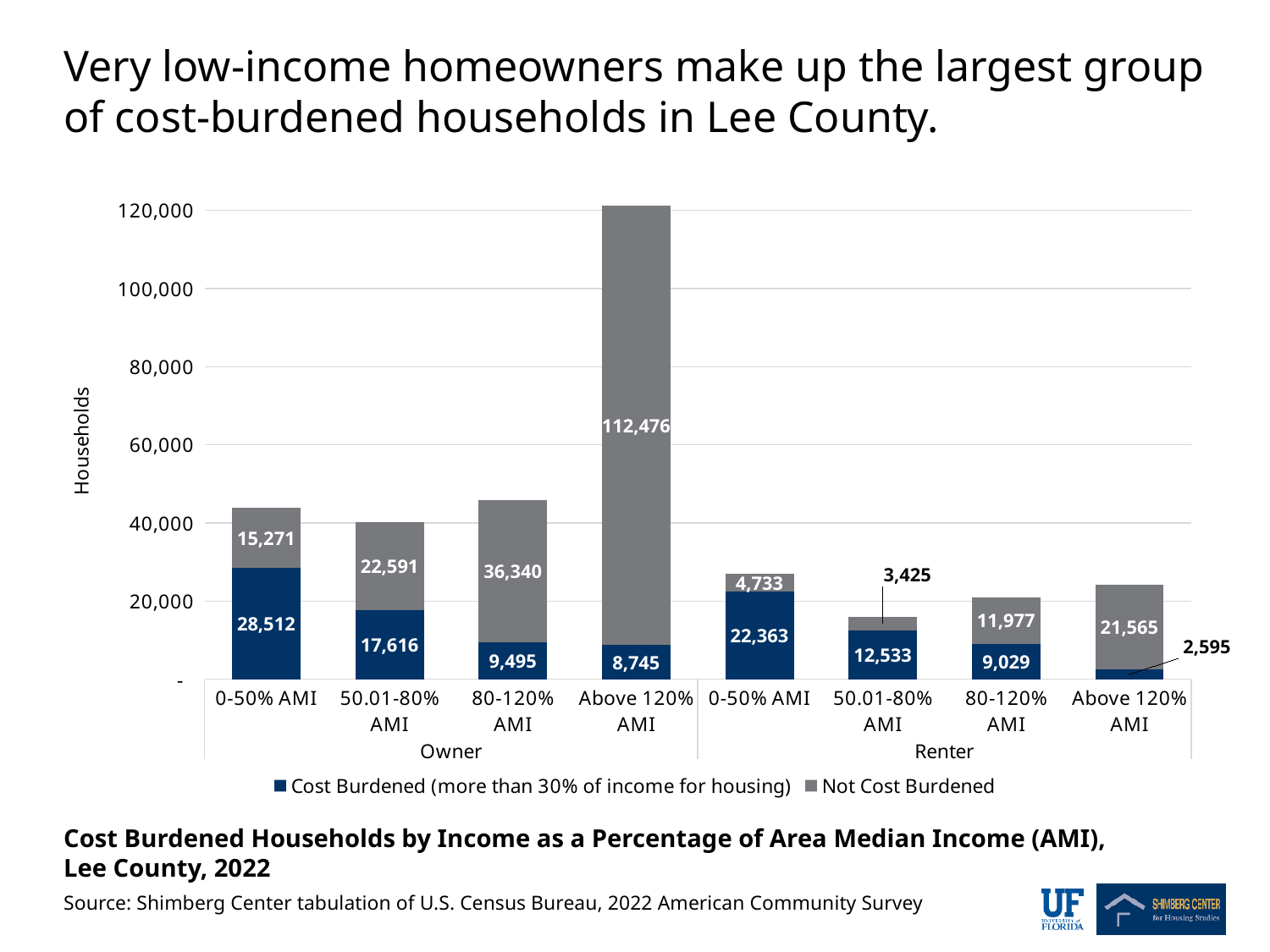
Which income group has the smallest number of cost-burdened households? Renter Above 120% AMI What is the number of not cost-burdened renter households in the 80-120% AMI group? 11,977 What is the total number of households in the Renter 0-50% AMI bar? 27,096 What is the number of cost-burdened owner households in the 0-50% AMI group? 28,512 Which income group has the largest number of cost-burdened households? Owner 0-50% AMI What is the difference between cost-burdened owner households in the 0-50% AMI group and cost-burdened renter households in the 0-50% AMI group? 6,149 What is the number of cost-burdened renter households in the Above 120% AMI group? 2,595 What type of chart is shown on the slide? Stacked bar chart How many income group bars are shown in the chart? 8 How many series does the legend list? 2 What is the total number of households in the Owner Above 120% AMI bar? 121,221 Which is larger: the number of cost-burdened owner households in the 50.01-80% AMI group or the number of cost-burdened renter households in the 50.01-80% AMI group? Owner 50.01-80% AMI